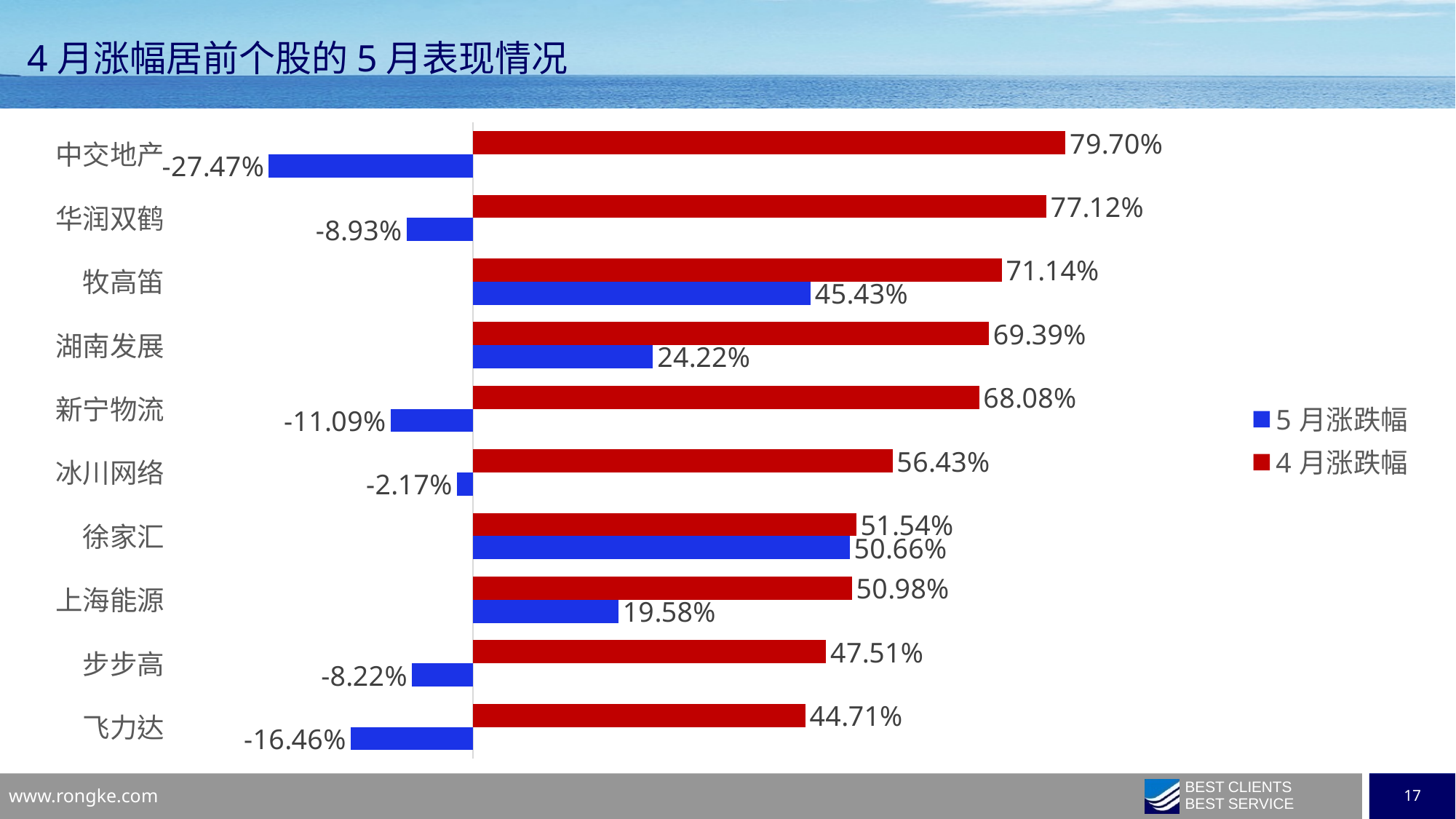
What is the 5月涨跌幅 value for 牧高笛? 45.43% Which stock has the highest 5月涨跌幅? 徐家汇 Which stock has the highest 4月涨跌幅? 中交地产 Which colour represents 5月涨跌幅 in the legend? Blue What is the difference between the 4月涨跌幅 and 5月涨跌幅 for 牧高笛? 25.71 percentage points What is the 4月涨跌幅 value for 中交地产? 79.70% How many series does the legend list? 2 For 徐家汇, which is larger: the 4月涨跌幅 or the 5月涨跌幅? 4月涨跌幅 What is the 5月涨跌幅 value for 飞力达? -16.46% Which stock has the lowest 5月涨跌幅? 中交地产 What kind of chart is shown on the slide? Bar chart How many stocks are shown in the chart? 10